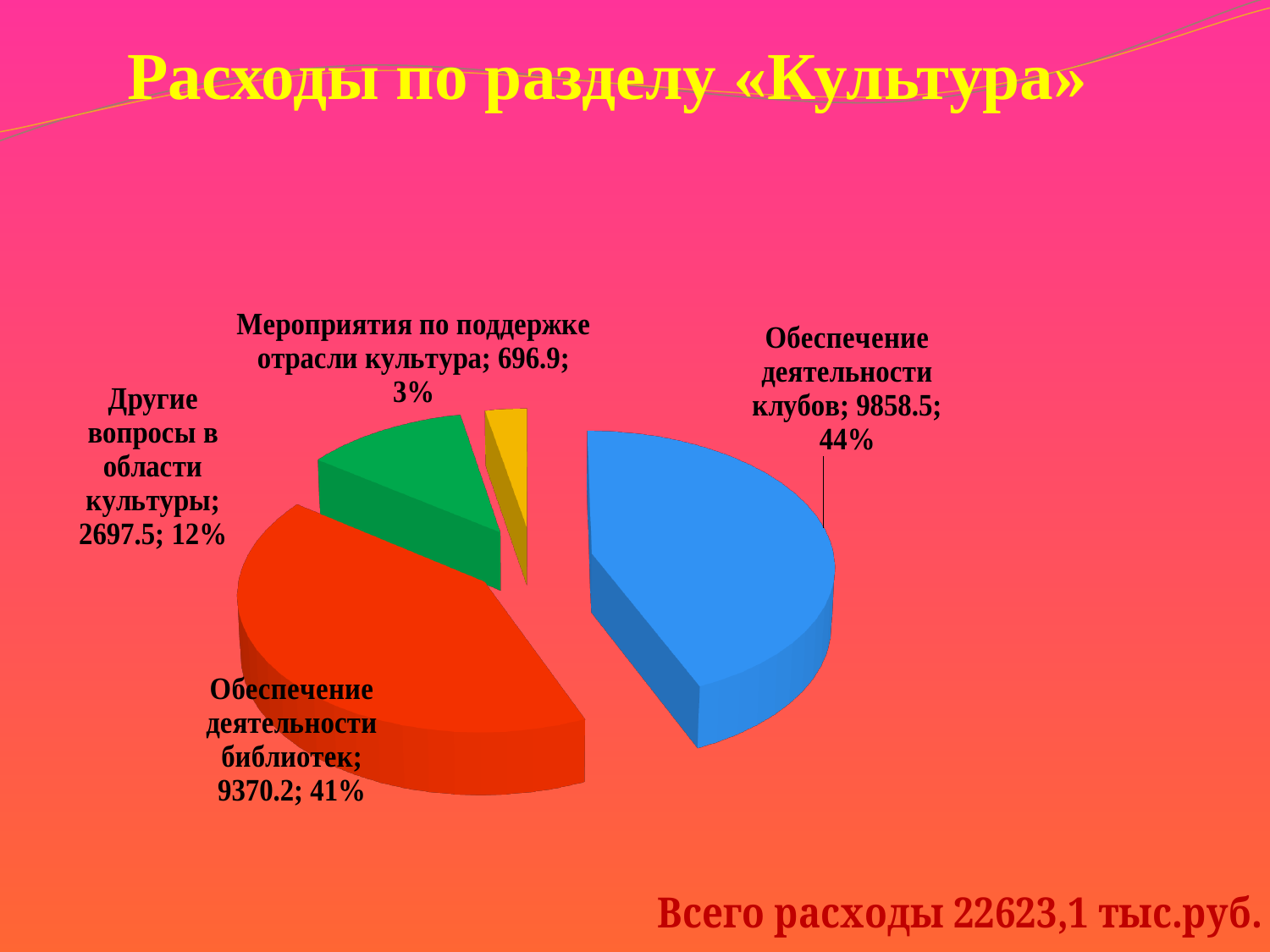
What is the value for «Обеспечение деятельности клубов»? 9858.5 What is the value for «Обеспечение деятельности библиотек»? 9370.2 What is the value for «Мероприятия по поддержке отрасли культура»? 696.9 What share of the pie does «Другие вопросы в области культуры» take? 12% What is the title of the chart on the slide? Всего расходы 22623,1 тыс.руб. Which category has the largest slice? Обеспечение деятельности клубов Which is larger: «Другие вопросы в области культуры» or «Мероприятия по поддержке отрасли культура»? Другие вопросы в области культуры What is the difference between the values for «Обеспечение деятельности клубов» and «Обеспечение деятельности библиотек»? 488.3 What share of the pie does «Обеспечение деятельности клубов» take? 44% Which category has the smallest slice? Мероприятия по поддержке отрасли культура What kind of chart is shown on the slide? Pie chart How many slices does the pie chart have? 4